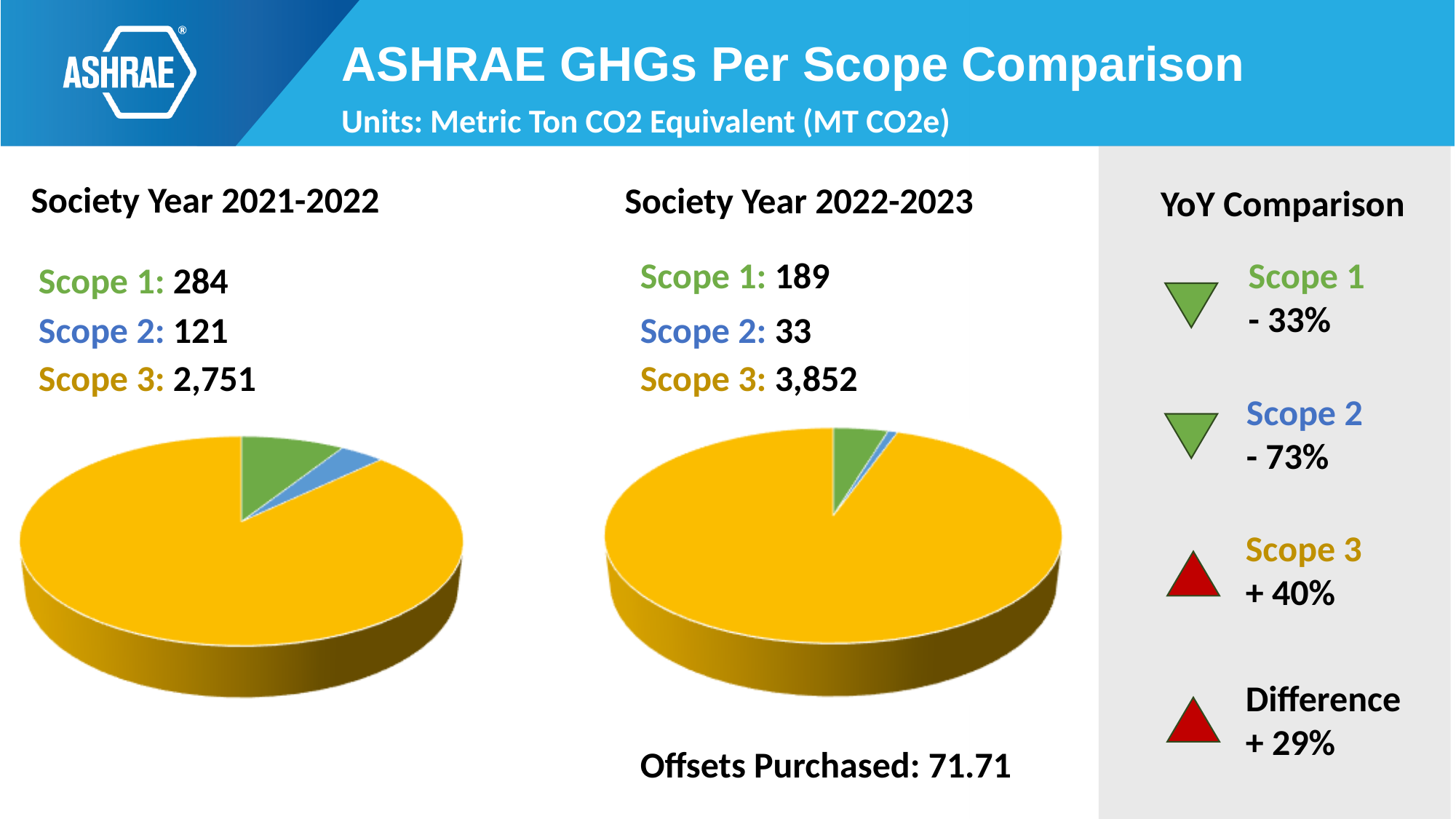
In the Society Year 2021-2022 chart, what is the difference between Scope 1 and Scope 2? 163 In the Society Year 2021-2022 chart, which scope has the largest value? Scope 3 In the Society Year 2021-2022 chart, what is the value for Scope 1? 284 Which is larger: Scope 1 in Society Year 2021-2022 or Scope 1 in Society Year 2022-2023? Scope 1 in Society Year 2021-2022 In the Society Year 2022-2023 chart, what is the value for Scope 3? 3,852 In the Society Year 2022-2023 chart, which scope has the smallest value? Scope 2 In the Society Year 2022-2023 chart, what is the value for Scope 2? 33 What is the difference between the Scope 3 value in Society Year 2022-2023 and the Scope 3 value in Society Year 2021-2022? 1,101 How many scopes (slices) does the Society Year 2022-2023 pie chart show? 3 What is the total of the three scope values in the Society Year 2021-2022 chart? 3,156 What kind of chart is used for Society Year 2021-2022? Pie chart What units are the chart values given in, according to the slide header? Metric Ton CO2 Equivalent (MT CO2e)